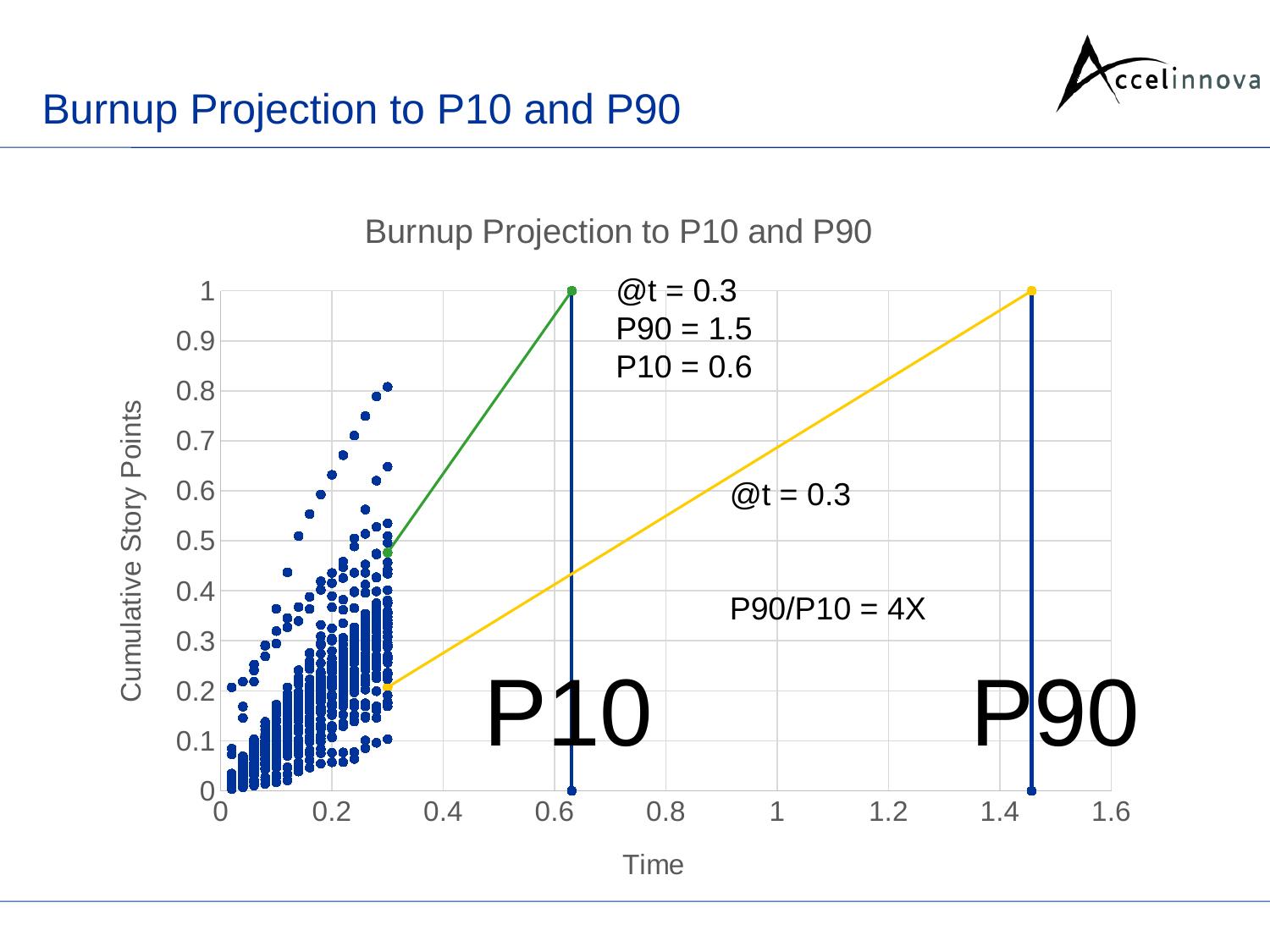
What is the title of the chart? Burnup Projection to P10 and P90 What ratio of P90 to P10 is stated on the chart? 4X According to the annotation, what is the P90 value at t = 0.3? 1.5 What is the difference between the P90 and P10 values stated at t = 0.3? 0.9 Is the time at which the P90 vertical line is drawn greater or less than 1.4? greater According to the annotation, what is the P10 value at t = 0.3? 0.6 Is the time at which the P10 vertical line is drawn greater or less than 0.8? less What kind of chart is shown on the slide? scatter chart Which projection lands at a later time, P10 or P90? P90 Is the largest time value among the blue scatter points greater or less than 0.4? less What colour is the projection line that leads to the P10 marker? green